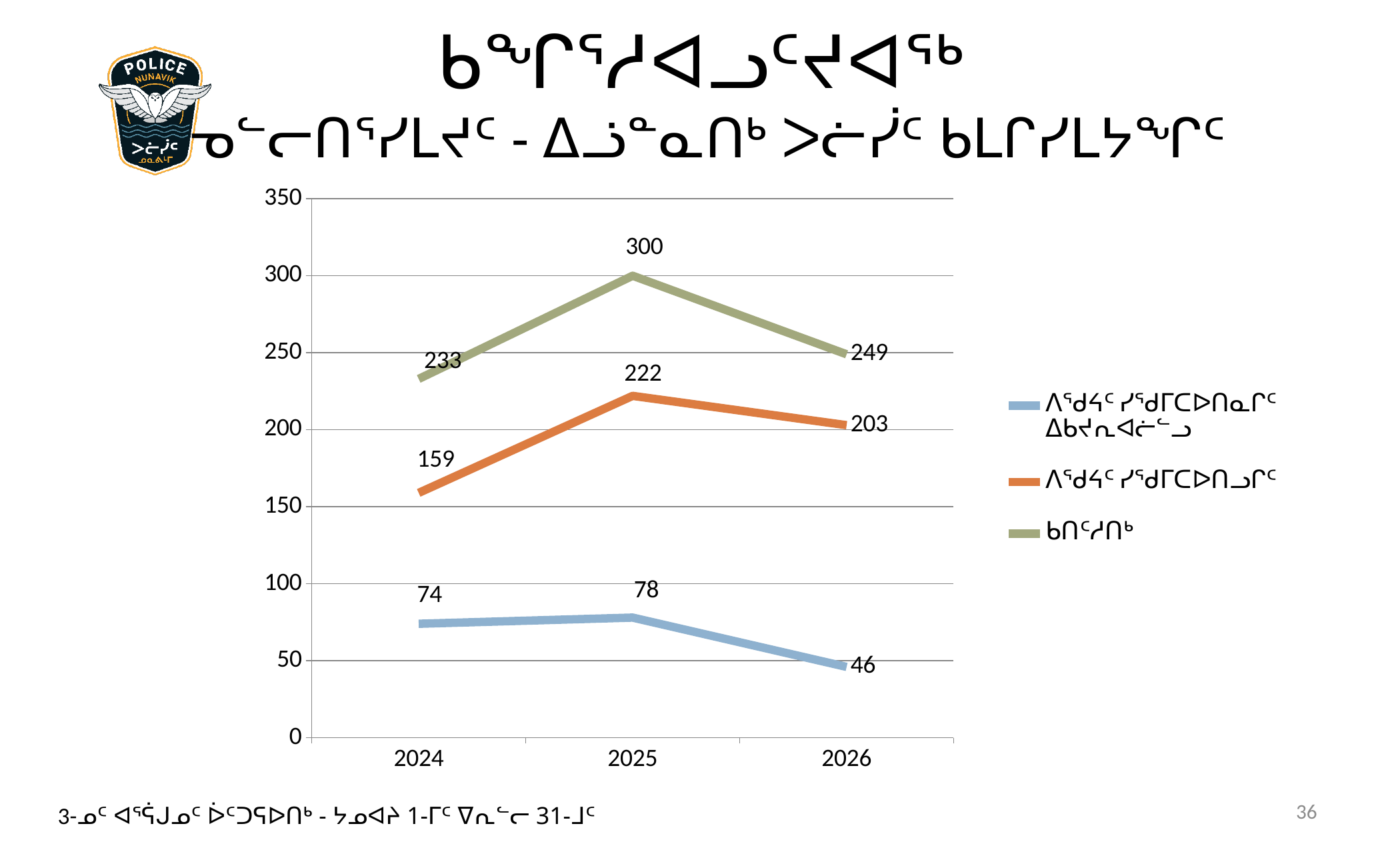
What is the value of the green line in 2025? 300 What is the value of the orange line in 2024? 159 In which year does the orange line reach its highest value? 2025 What is the difference between the green line's values in 2025 and 2026? 51 Which is larger in 2026: the orange line's value or the green line's value? the green line (249) How many years are shown on the x axis? 3 In which year is the blue line at its lowest value? 2026 Does the blue line rise or fall from 2025 to 2026? fall How many series does the legend list? 3 What is the difference between the orange line's values in 2025 and 2024? 63 What kind of chart is shown on the slide? line chart What is the value of the blue line in 2026? 46